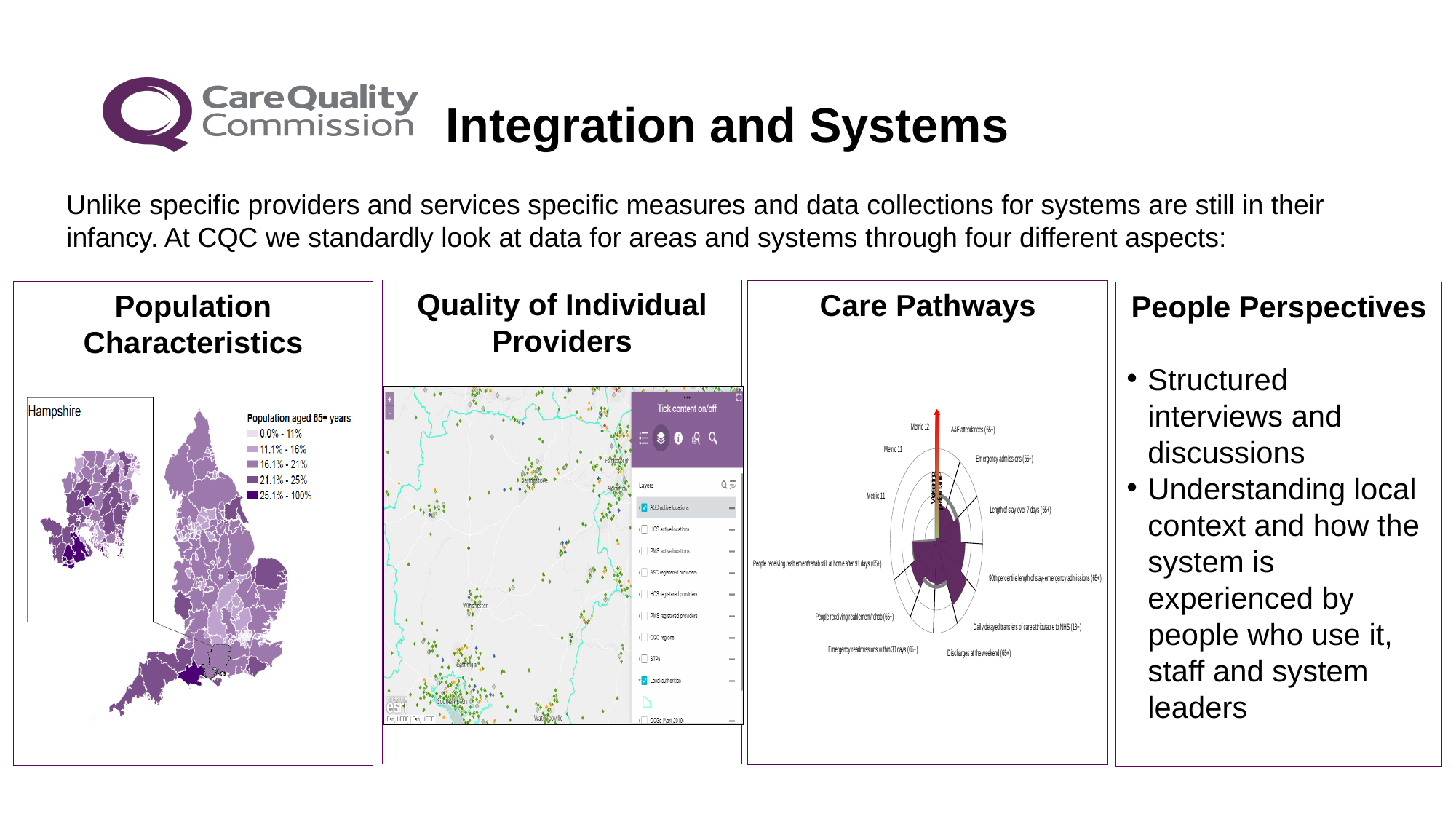
Which area is shown in the inset box of the Population Characteristics map? Hampshire In the Population Characteristics map legend, what range does the darkest shade represent? 25.1% - 100% In the Population Characteristics map, how many shading bands does the legend list? 5 In the Population Characteristics map legend, what range does the lightest shade represent? 0.0% - 11% What is the title of the legend on the Population Characteristics map? Population aged 65+ years How many metric categories are arranged around the radar chart in the Care Pathways panel? 12 What kind of chart is shown in the Care Pathways panel? radar chart